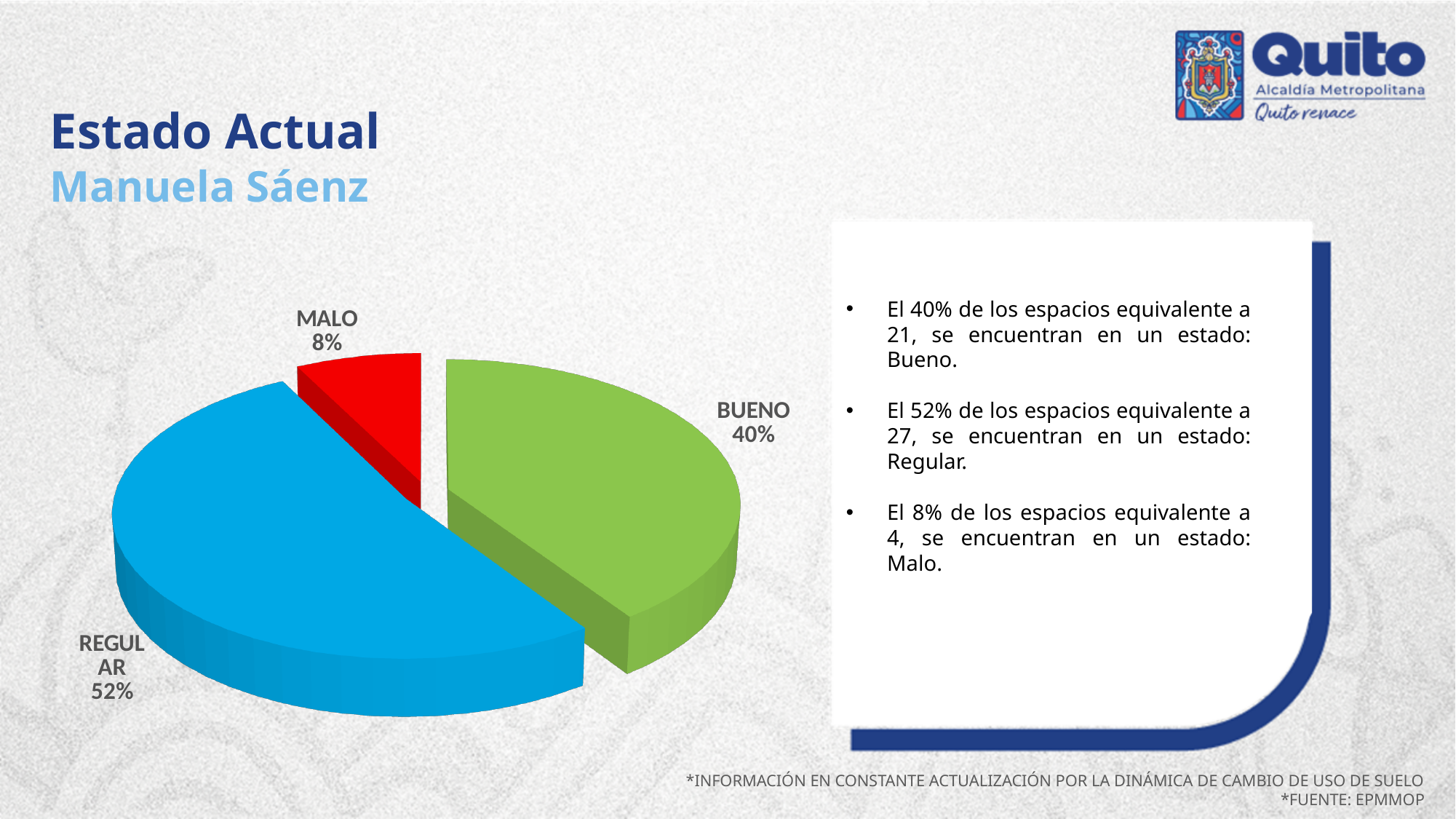
What percentage of the pie is labelled BUENO? 40% How many slices does the pie chart have? 3 Which category has the smallest share of the pie? MALO What is the difference in percentage points between REGULAR and BUENO? 12 What is the difference in percentage points between BUENO and MALO? 32 What percentage of the pie is labelled MALO? 8% Which is larger, the share for BUENO or the share for MALO? BUENO What type of chart is shown on the slide? Pie chart What percentage of the pie is labelled REGULAR? 52% What colour is the REGULAR slice? Blue Which category has the largest share of the pie? REGULAR What colour is the MALO slice? Red